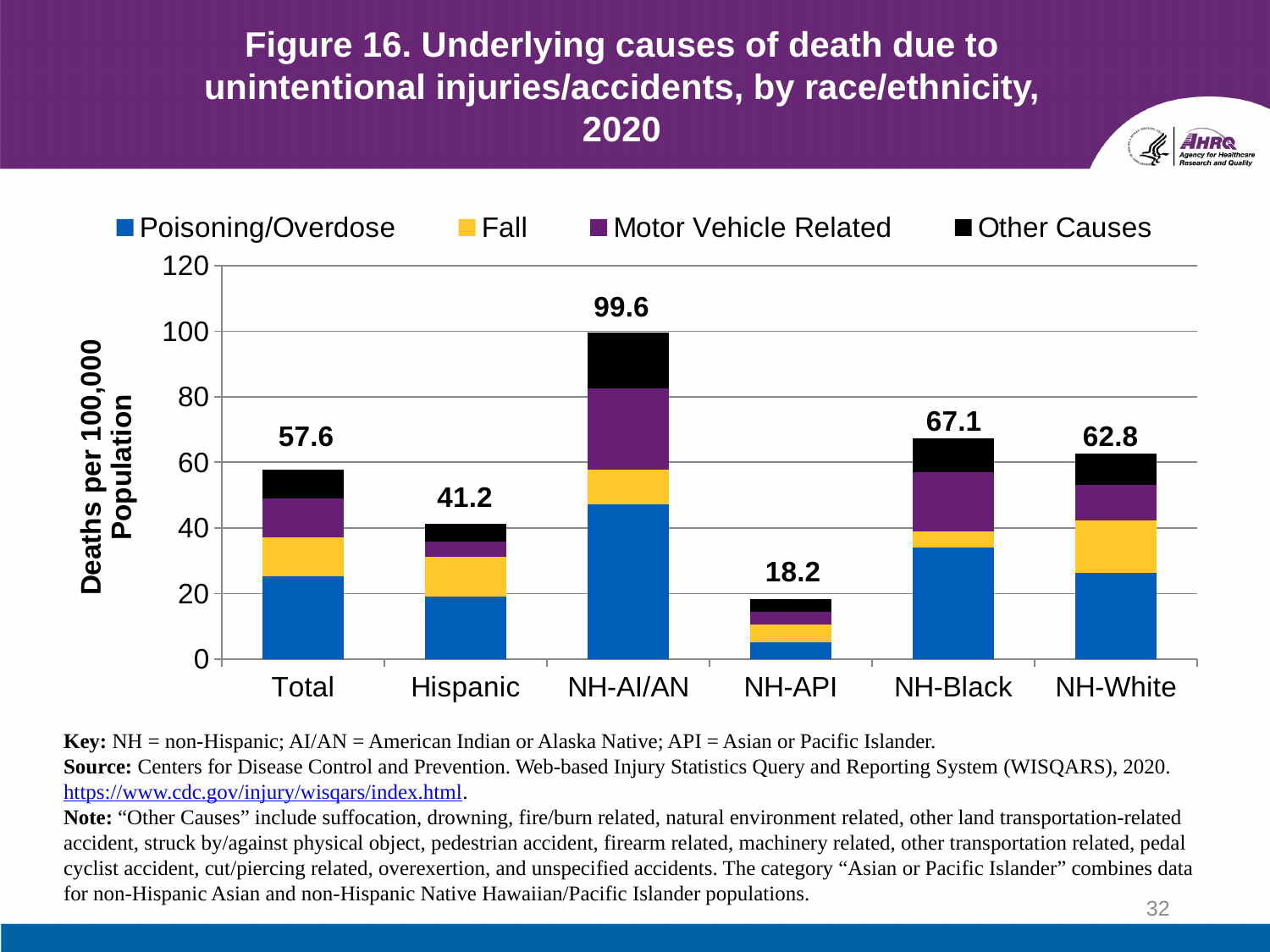
What is the difference between the total for NH-AI/AN and the total for NH-API? 81.4 What kind of chart is shown on the slide? Stacked bar chart Which has a larger total, NH-Black or NH-White? NH-Black Which race/ethnicity group has the lowest total deaths per 100,000 population? NH-API What is the total value shown for NH-Black? 67.1 Is the Poisoning/Overdose value for NH-AI/AN greater or less than 40? greater Which race/ethnicity group has the highest total deaths per 100,000 population? NH-AI/AN What is the total value shown for the Hispanic bar? 41.2 How many series does the legend list? 4 What is the total deaths per 100,000 population for NH-AI/AN? 99.6 How many race/ethnicity categories are shown on the x axis? 6 What is the difference between the Total bar and the Hispanic bar? 16.4